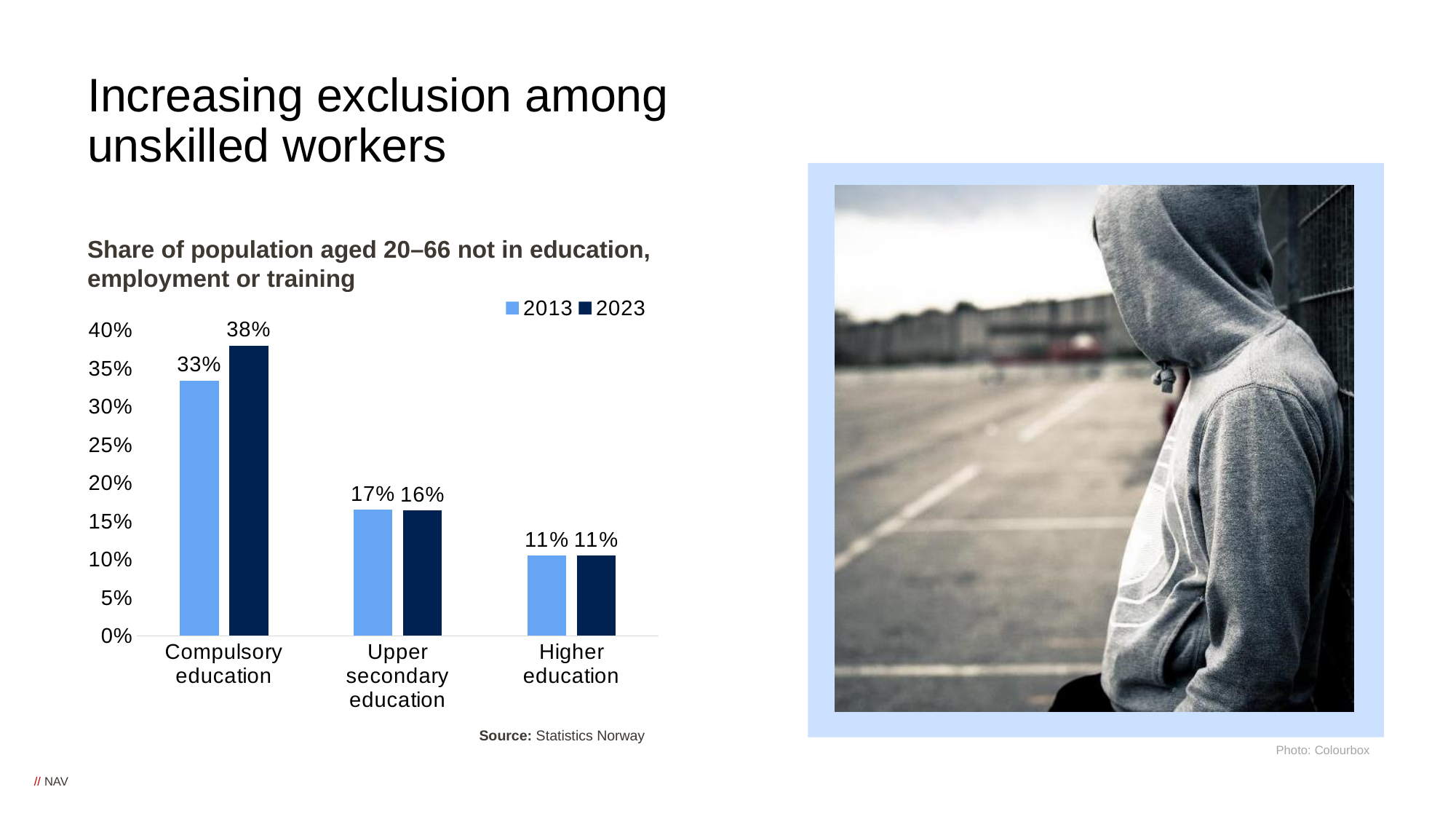
What is the difference between the 2023 and 2013 values for Compulsory education? 5 percentage points What is the source cited below the chart? Statistics Norway Which education category has the highest value in 2023? Compulsory education Is the 2023 value for Compulsory education greater or less than 35%? greater What is the value for Compulsory education in 2023? 38% How many series does the legend list? 2 What kind of chart is shown on the slide? Bar chart How many education categories are shown on the x axis? 3 What is the value for Higher education in 2023? 11% Which education category has the lowest value in 2013? Higher education Which is larger for Upper secondary education: the 2013 value or the 2023 value? 2013 What is the value for Upper secondary education in 2013? 17%